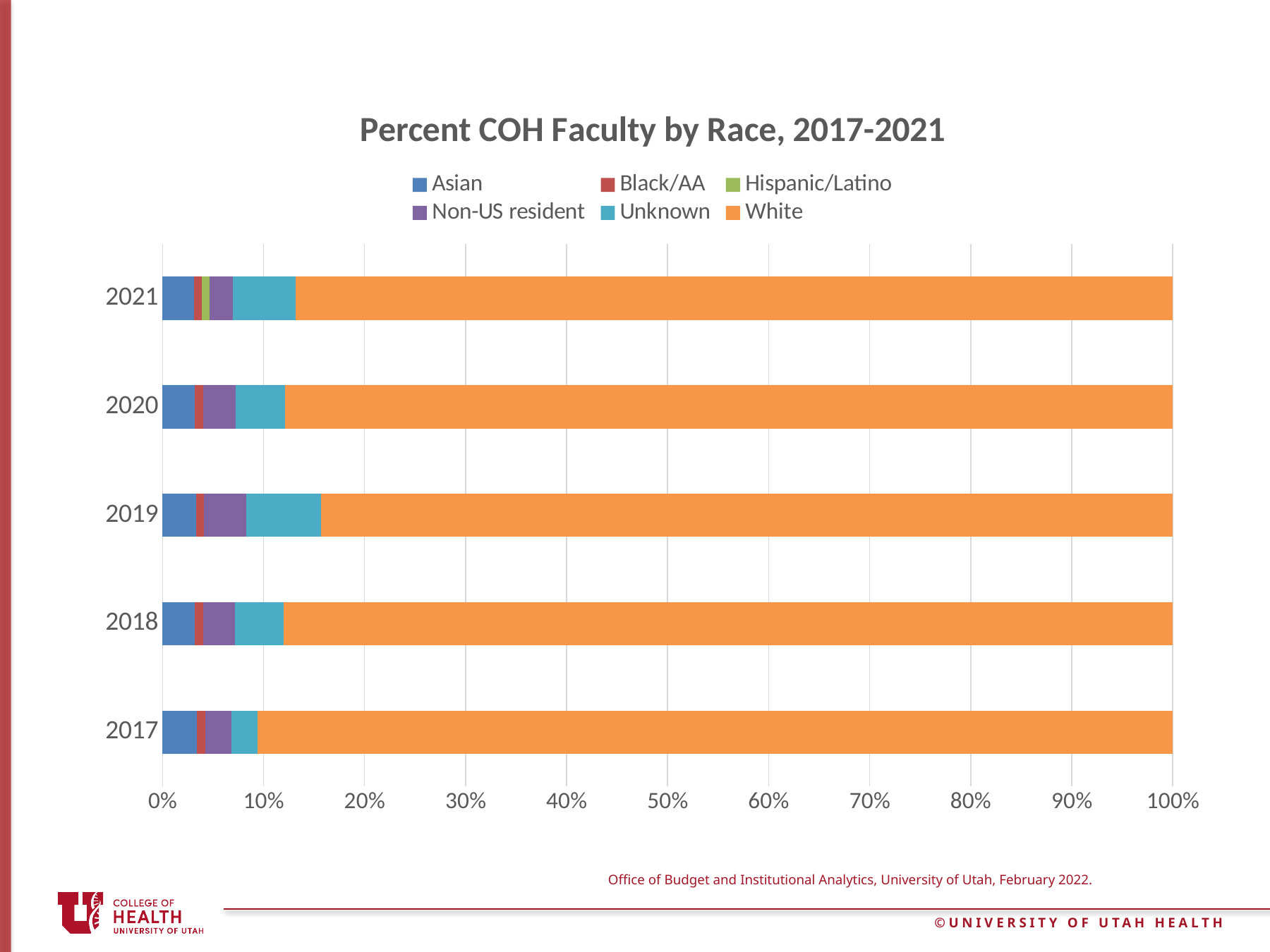
Is the White share larger in 2017 or in 2019? 2017 How many years (categories) are shown on the chart? 5 What is the total of the 2021 stacked bar? 100% Is the value for White in 2017 greater or less than 80%? greater Which series is shown in orange? White Is the value for Asian in 2021 greater or less than 10%? less What is the title of the chart? Percent COH Faculty by Race, 2017-2021 Which year has the largest Unknown segment? 2019 Which year has the largest White share? 2017 What kind of chart is shown on the slide? Stacked bar chart How many series does the legend list? 6 Which year has the smallest Unknown segment? 2017